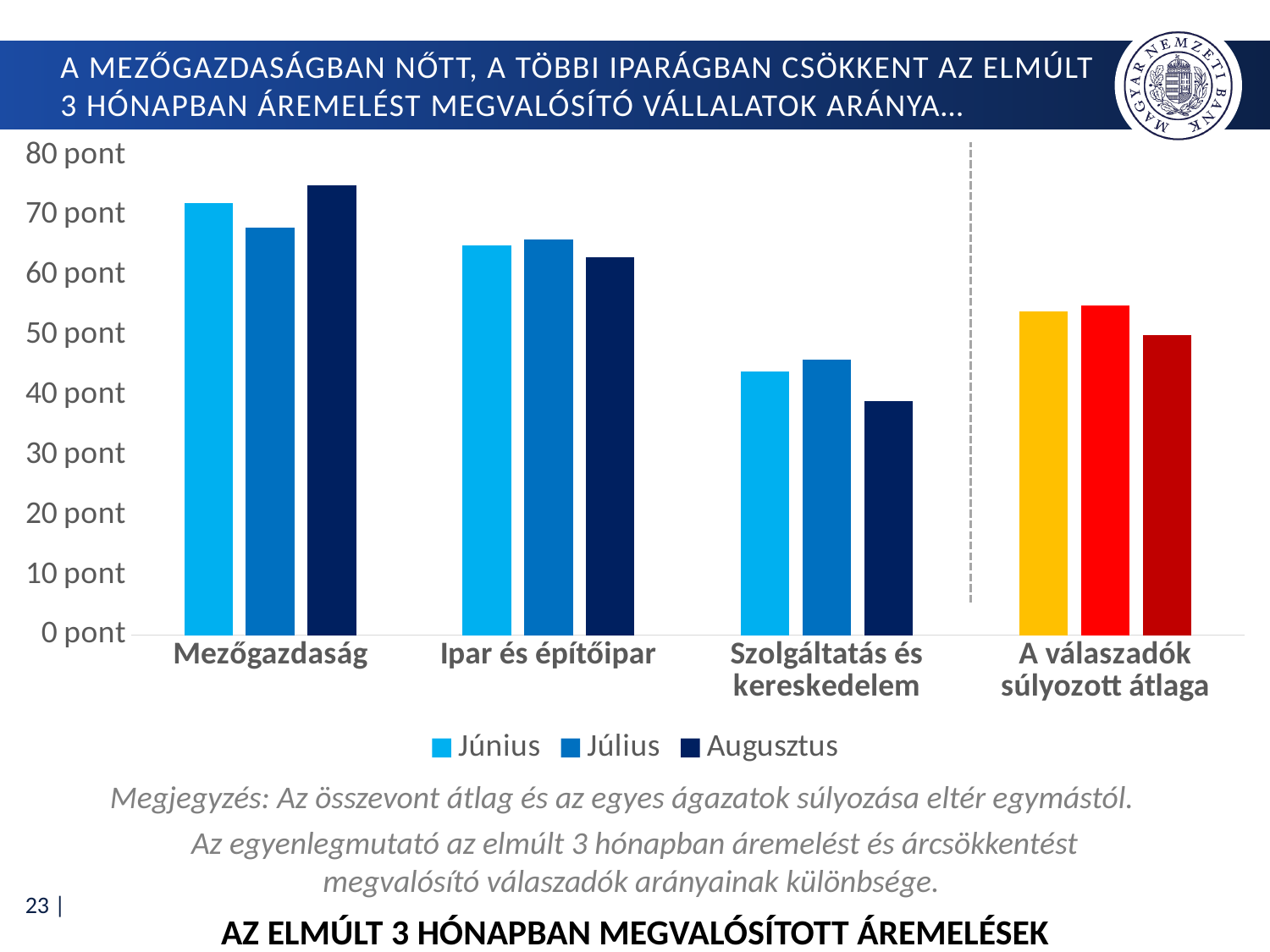
Which category has the lowest Augusztus bar? Szolgáltatás és kereskedelem For Mezőgazdaság, which is larger: the Július value or the Augusztus value? Augusztus What are the three series named in the legend? Június, Július, Augusztus Is the Július value for A válaszadók súlyozott átlaga greater or less than 50 pont? greater Which category has the highest Augusztus bar? Mezőgazdaság What kind of chart is shown on the slide? bar chart Is the Június value for Ipar és építőipar greater or less than 60 pont? greater For Szolgáltatás és kereskedelem, which is larger: the Június value or the Augusztus value? Június How many series does the legend list? 3 Is the Augusztus value for Mezőgazdaság greater or less than 70 pont? greater How many categories are shown on the x axis? 4